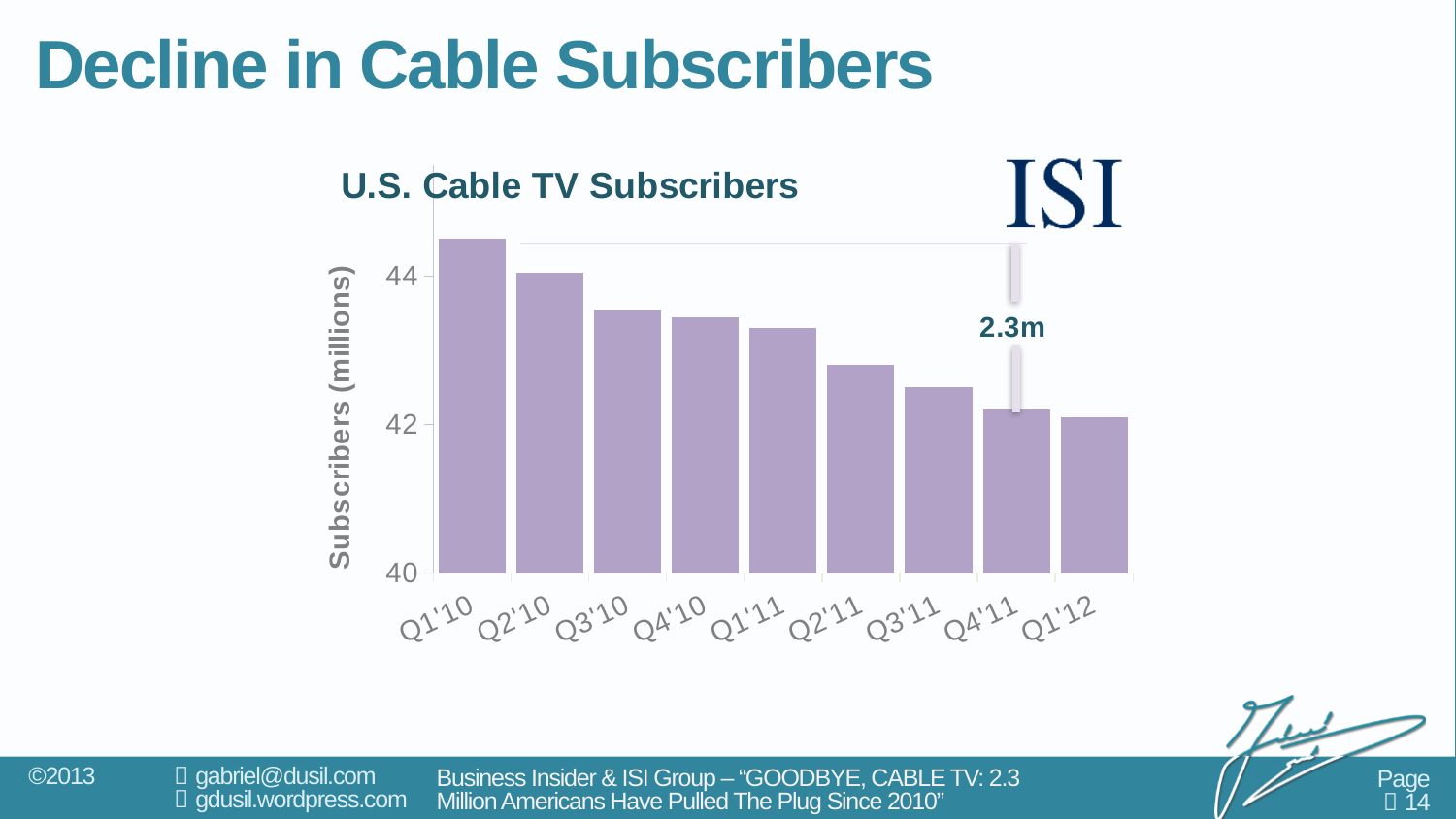
Which is larger, the value for Q3'10 or the value for Q2'11? Q3'10 Is the value for Q3'11 greater or less than 44? less What is the label on the vertical axis of the chart? Subscribers (millions) Is the value for Q1'10 greater or less than 44? greater What is the title of the chart? U.S. Cable TV Subscribers Is the value for Q3'10 greater or less than 44? less Which quarter has the highest number of subscribers? Q1'10 Which is larger, the value for Q1'10 or the value for Q1'12? Q1'10 What kind of chart is shown on the slide? Bar chart Do subscriber numbers rise or fall from Q1'10 to Q1'12? Fall How many quarters are plotted on the chart? 9